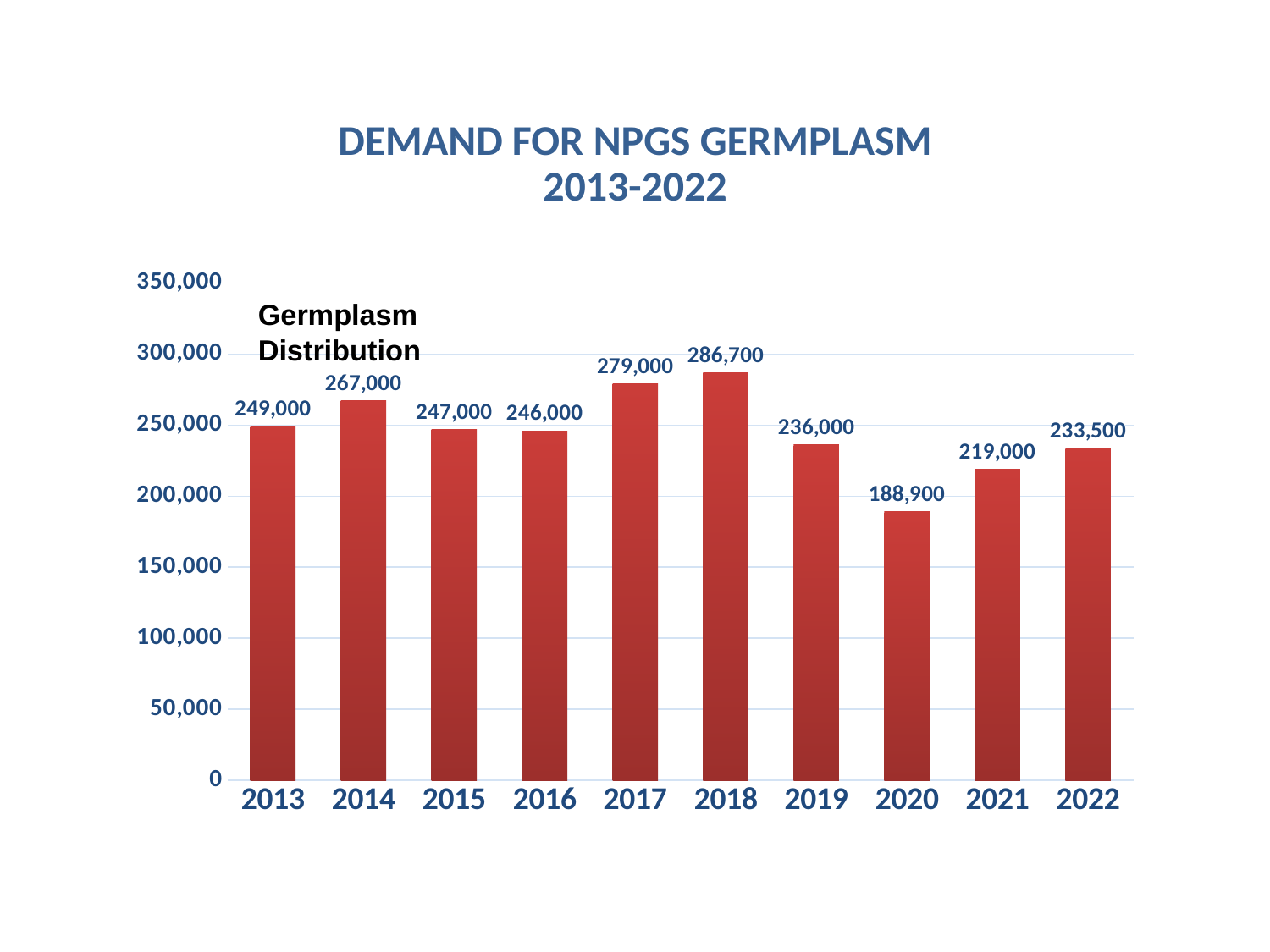
What is the difference between the 2018 value and the 2020 value? 97,800 Is the value for 2021 greater or less than 250,000? less Which year has a larger value, 2017 or 2019? 2017 What kind of chart is shown on the slide? bar chart What is the difference between the 2014 value and the 2013 value? 18,000 What is the germplasm distribution value for 2018? 286,700 Which year has the highest germplasm distribution? 2018 What is the germplasm distribution value for 2020? 188,900 What is the title of the chart? DEMAND FOR NPGS GERMPLASM 2013-2022 What is the value shown for 2022? 233,500 Which year has the lowest germplasm distribution? 2020 How many years are shown on the x axis? 10